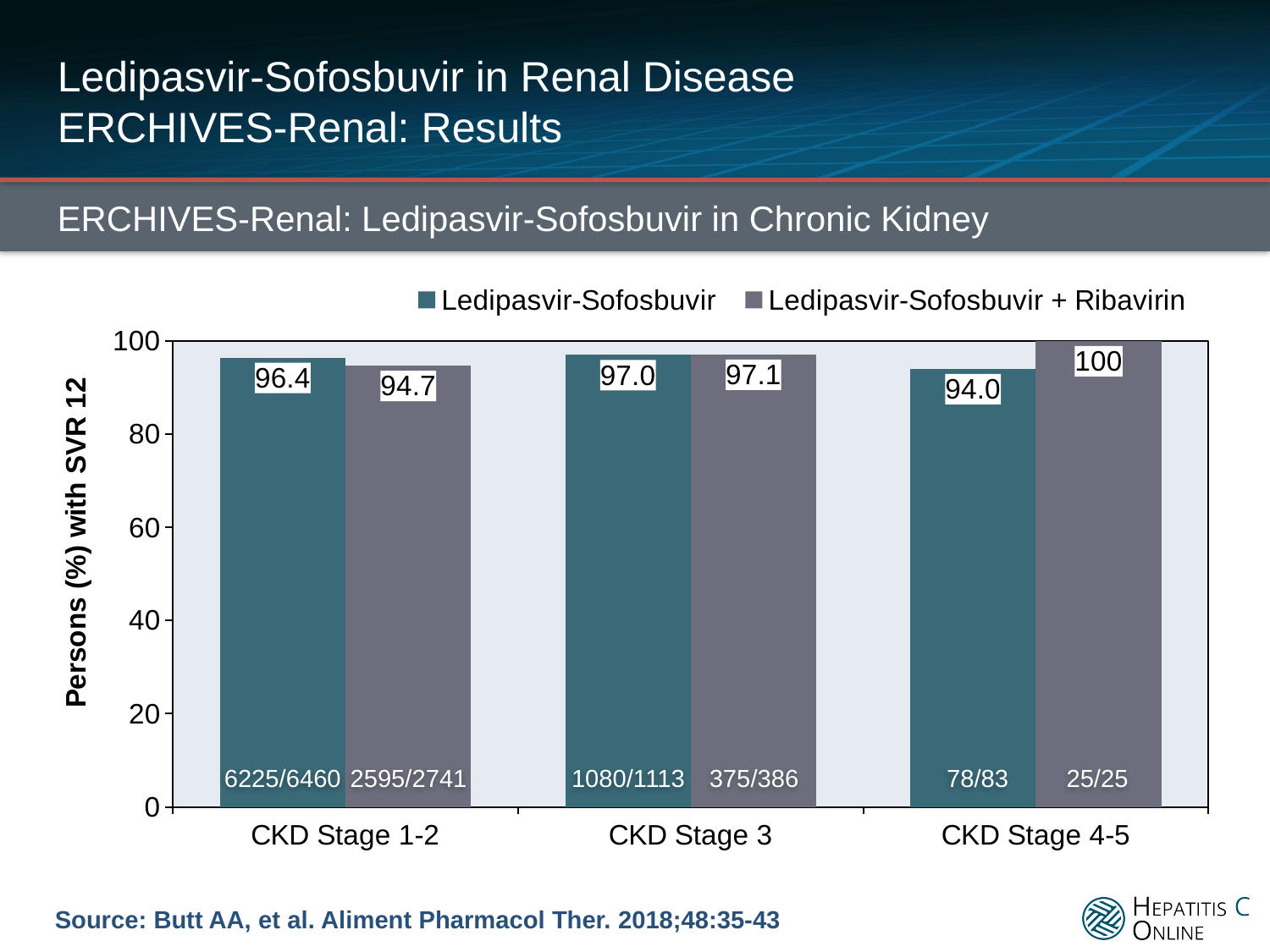
What is the SVR 12 rate for Ledipasvir-Sofosbuvir + Ribavirin in CKD Stage 4-5? 100 Which CKD stage has the highest SVR 12 rate for Ledipasvir-Sofosbuvir + Ribavirin? CKD Stage 4-5 What is the label of the y axis? Persons (%) with SVR 12 How many CKD stage categories are shown on the x axis? 3 In CKD Stage 1-2, which has the higher SVR 12 rate: Ledipasvir-Sofosbuvir or Ledipasvir-Sofosbuvir + Ribavirin? Ledipasvir-Sofosbuvir How many series does the legend list? 2 Which CKD stage has the lowest SVR 12 rate for Ledipasvir-Sofosbuvir? CKD Stage 4-5 What kind of chart is shown on the slide? Bar chart What is the difference between the Ledipasvir-Sofosbuvir + Ribavirin and Ledipasvir-Sofosbuvir SVR 12 rates in CKD Stage 4-5? 6.0 What is the SVR 12 rate for Ledipasvir-Sofosbuvir + Ribavirin in CKD Stage 3? 97.1 What is the SVR 12 rate for Ledipasvir-Sofosbuvir in CKD Stage 1-2? 96.4 What is the SVR 12 rate for Ledipasvir-Sofosbuvir in CKD Stage 4-5? 94.0